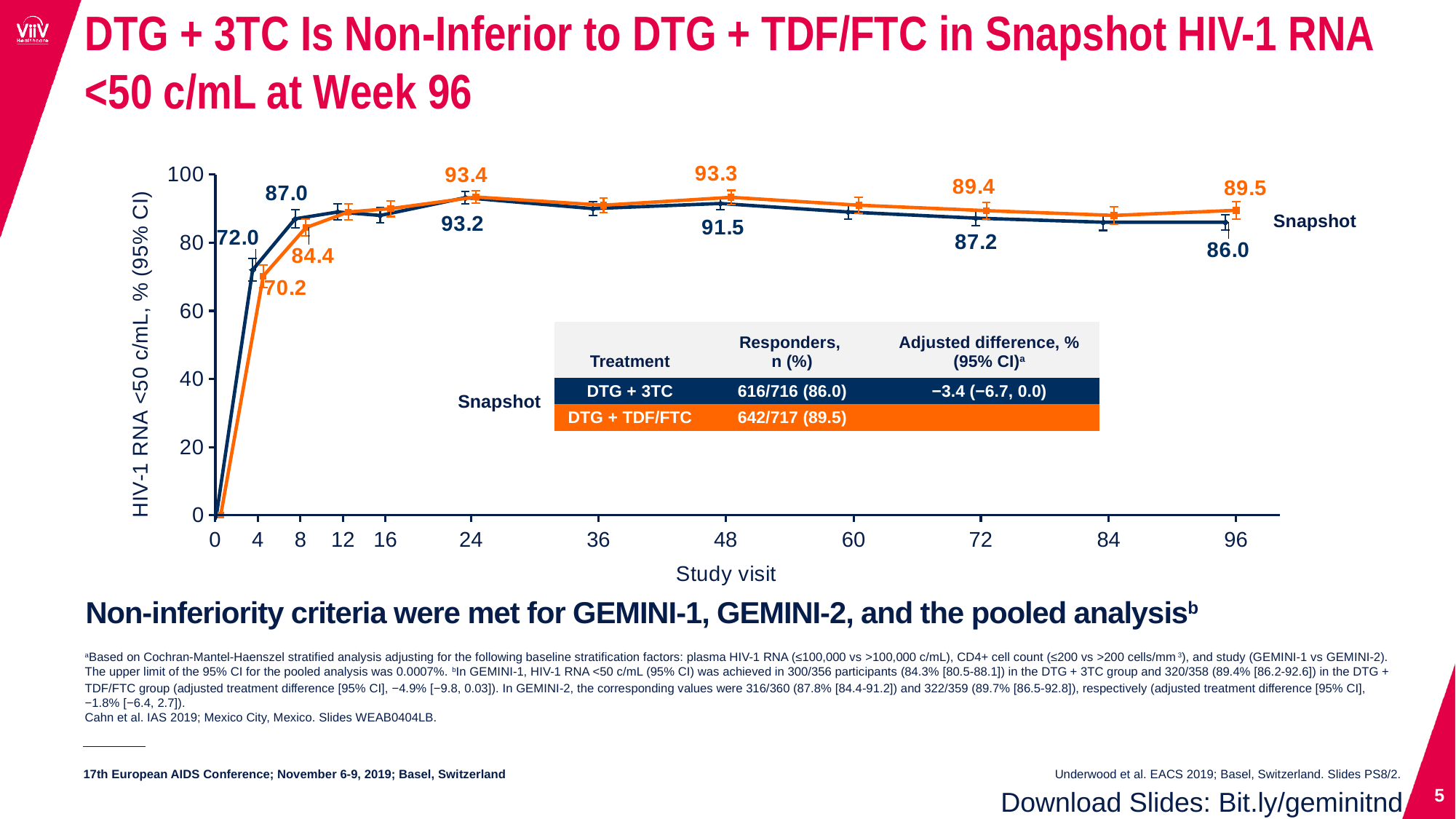
What is the value for DTG + 3TC at week 96? 86.0 What is the difference between the DTG + 3TC and DTG + TDF/FTC values at week 4? 1.8 At week 8, which treatment has the higher value, DTG + 3TC or DTG + TDF/FTC? DTG + 3TC What kind of chart is shown on the slide? Line chart At which study visit does DTG + TDF/FTC reach its highest labelled value? Week 24 What is the value for DTG + TDF/FTC at week 48? 93.3 What is the value for DTG + TDF/FTC at week 72? 89.4 What is the difference between the DTG + TDF/FTC and DTG + 3TC values at week 96? 3.5 Does the DTG + 3TC line rise or fall from week 24 to week 96? Fall What is the value for DTG + 3TC at week 4? 72.0 What is the label of the y axis? HIV-1 RNA <50 c/mL, % (95% CI) Is the value for DTG + 3TC at week 12 greater or less than 80? greater